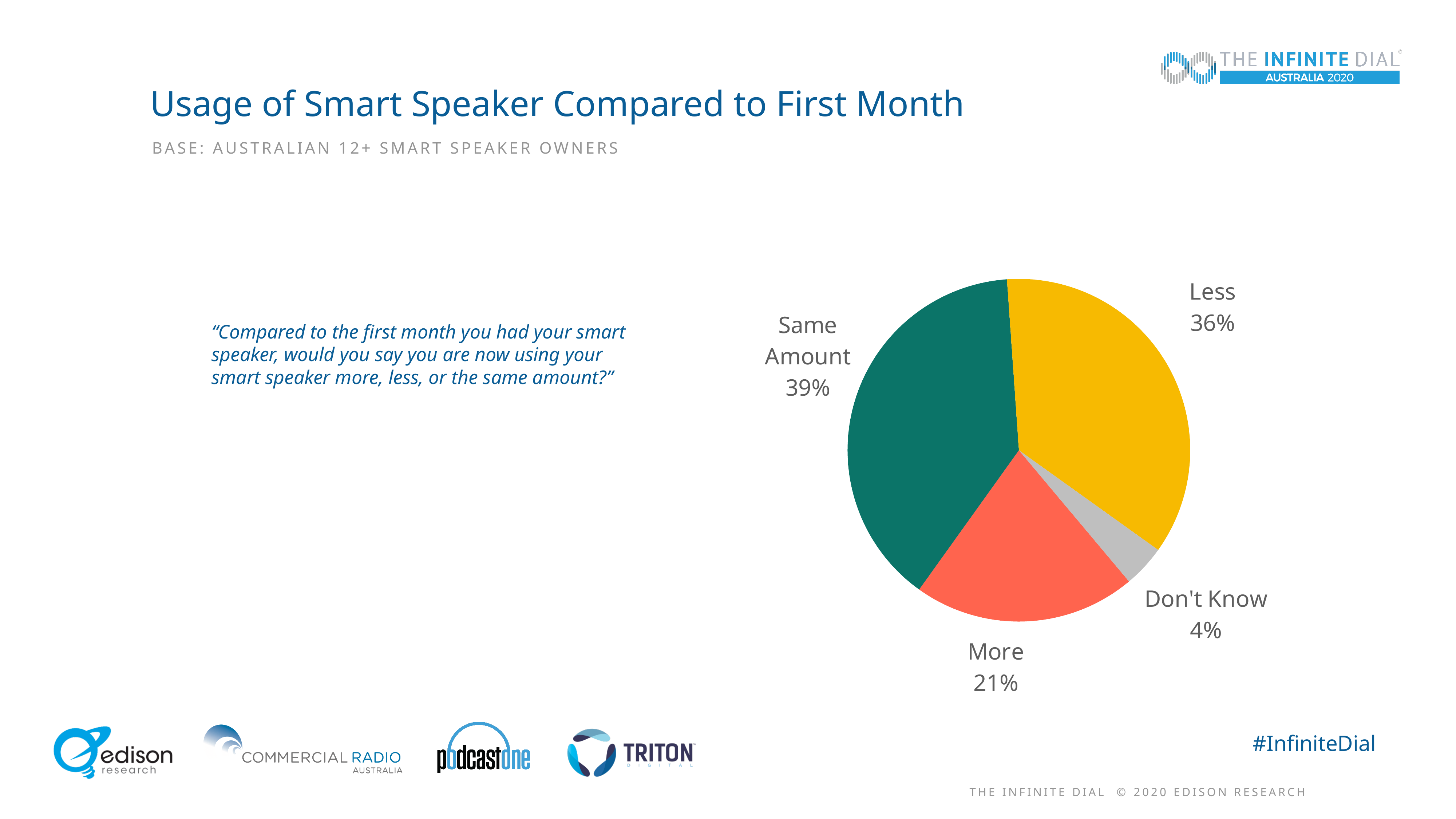
Which is larger, the share for 'More' or the share for 'Less'? Less What percentage of smart speaker owners say they use their smart speaker the same amount as in the first month? 39% What is the difference in percentage points between 'Same Amount' and 'Less'? 3 How many slices does the pie chart have? 4 What percentage of smart speaker owners say they use their smart speaker less than in the first month? 36% Which response has the smallest share of the pie? Don't Know What is the difference in percentage points between 'Less' and 'More'? 15 What kind of chart is shown on the slide? Pie chart Which response has the largest share of the pie? Same Amount What percentage of smart speaker owners answered 'Don't Know'? 4% What is the title of the chart on the slide? Usage of Smart Speaker Compared to First Month What percentage of smart speaker owners say they use their smart speaker more than in the first month? 21%